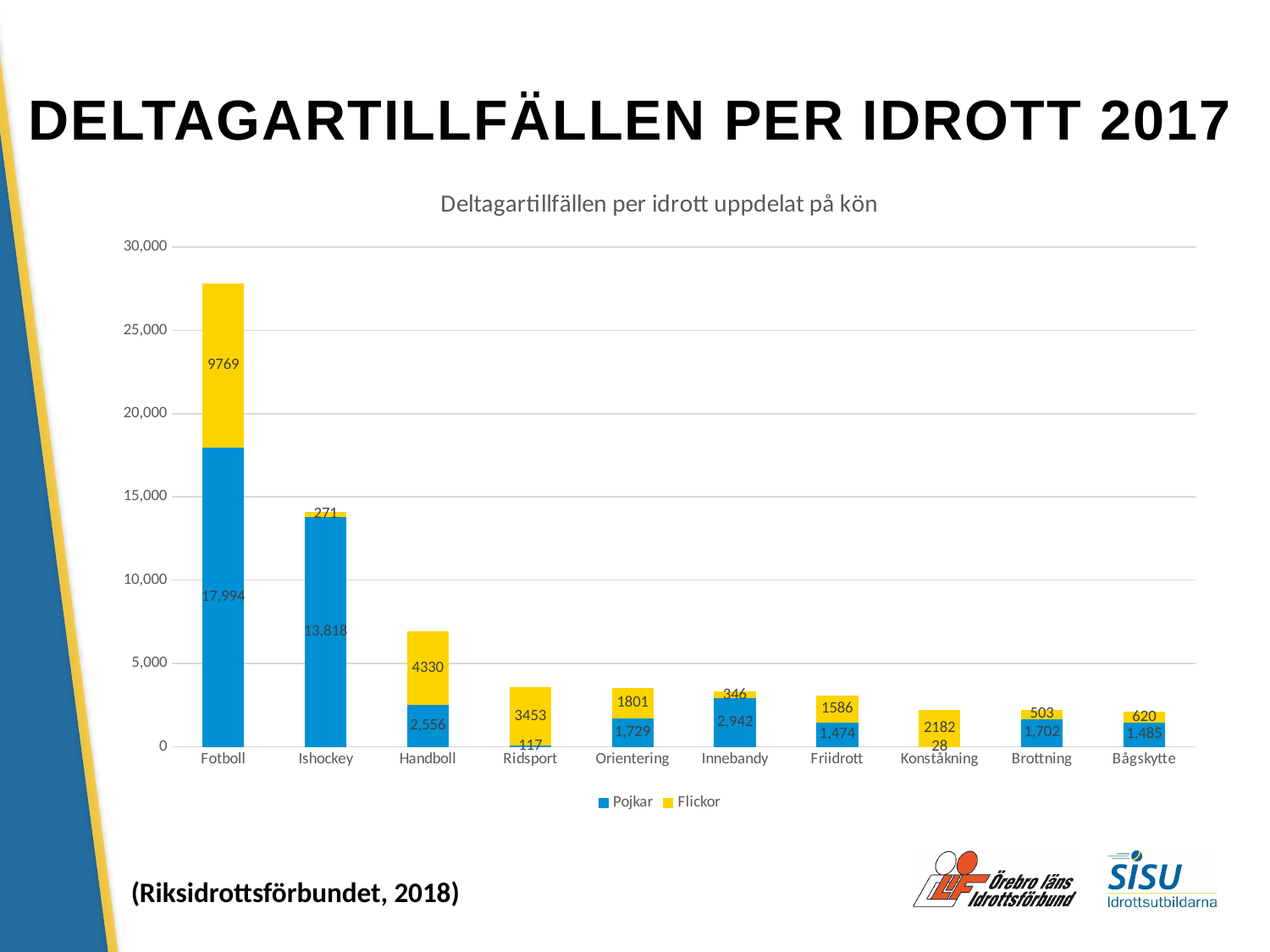
What is the difference between the Pojkar values for Fotboll and Ishockey? 4,176 Is the total stacked bar for Ishockey greater or less than 15,000? less What is the total of the stacked bar for Ridsport? 3570 Which sport has the lowest Pojkar value? Konståkning What type of chart is shown on the slide? stacked bar chart Which is larger for Innebandy, the Pojkar value or the Flickor value? Pojkar What is the Flickor value for Handboll? 4330 How many sports (categories) are shown on the x axis? 10 How many series does the legend list? 2 Which sport has the highest Flickor value? Fotboll What is the Pojkar value for Konståkning? 28 What is the Pojkar value for Fotboll? 17,994